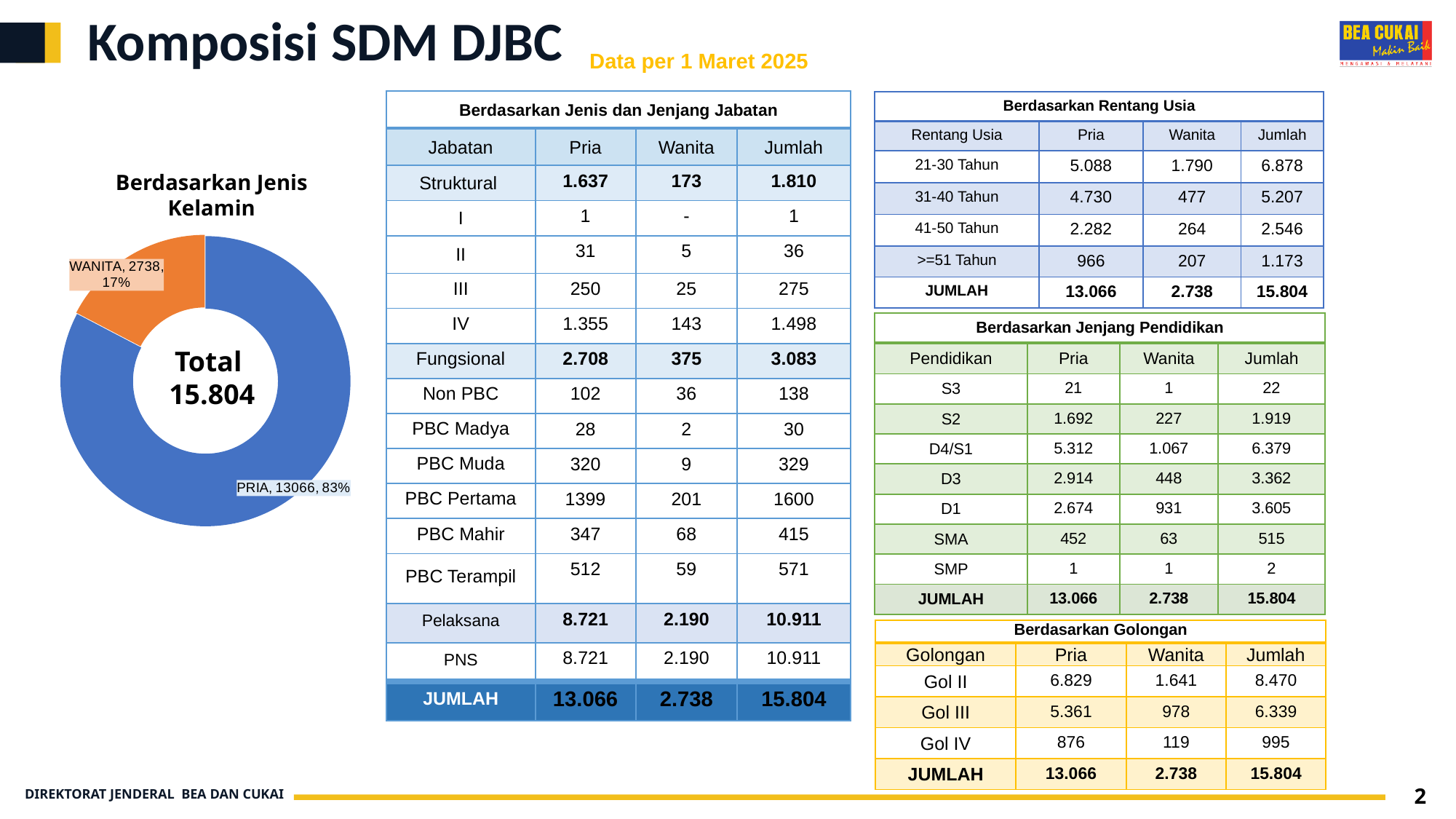
In the "Berdasarkan Jenis Kelamin" chart, what is the difference between the PRIA and WANITA values? 10328 In the "Berdasarkan Jenis Kelamin" chart, what share of the total does WANITA represent? 17% In the "Berdasarkan Jenis Kelamin" chart, what share of the total does PRIA represent? 83% What total is shown in the centre of the "Berdasarkan Jenis Kelamin" chart? 15.804 What kind of chart is the "Berdasarkan Jenis Kelamin" chart? Pie chart (donut) In the "Berdasarkan Jenis Kelamin" chart, what is the value for PRIA? 13066 In the "Berdasarkan Jenis Kelamin" chart, which category has the largest slice? PRIA How many slices does the "Berdasarkan Jenis Kelamin" chart have? 2 In the "Berdasarkan Jenis Kelamin" chart, which category has the smallest slice? WANITA In the "Berdasarkan Jenis Kelamin" chart, which is larger, PRIA or WANITA? PRIA In the "Berdasarkan Jenis Kelamin" chart, what colour is the PRIA slice? Blue In the "Berdasarkan Jenis Kelamin" chart, what is the value for WANITA? 2738